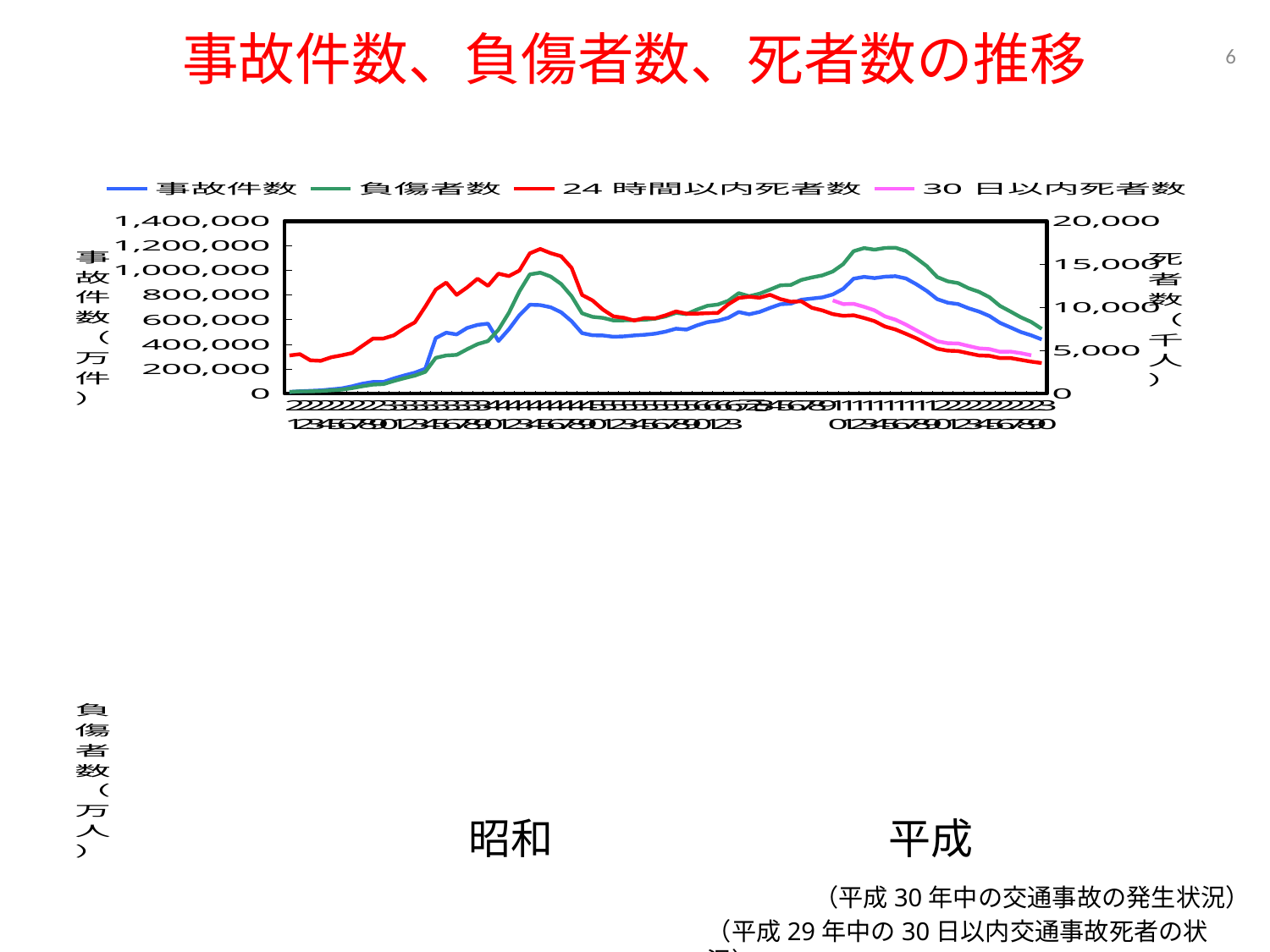
Which series reaches the highest value on the left axis? 負傷者数 How many series does the legend list? 4 Is the peak value of 負傷者数 greater or less than 1,000,000? greater At the right end of the chart, which is higher: 負傷者数 or 事故件数? 負傷者数 What kind of chart is shown on the slide? line chart Is the peak value of 24 時間以内死者数 on the right axis greater or less than 15,000? greater Is the peak value of 事故件数 greater or less than 800,000? greater Which series is plotted only for the later (平成) part of the chart? 30 日以内死者数 Which colour is used for the 負傷者数 series? green What is the title of the slide's chart? 事故件数、負傷者数、死者数の推移 Does the 24 時間以内死者数 series rise or fall over the 平成 period at the right of the chart? fall Does the 負傷者数 series rise or fall over the final years shown at the right of the chart? fall